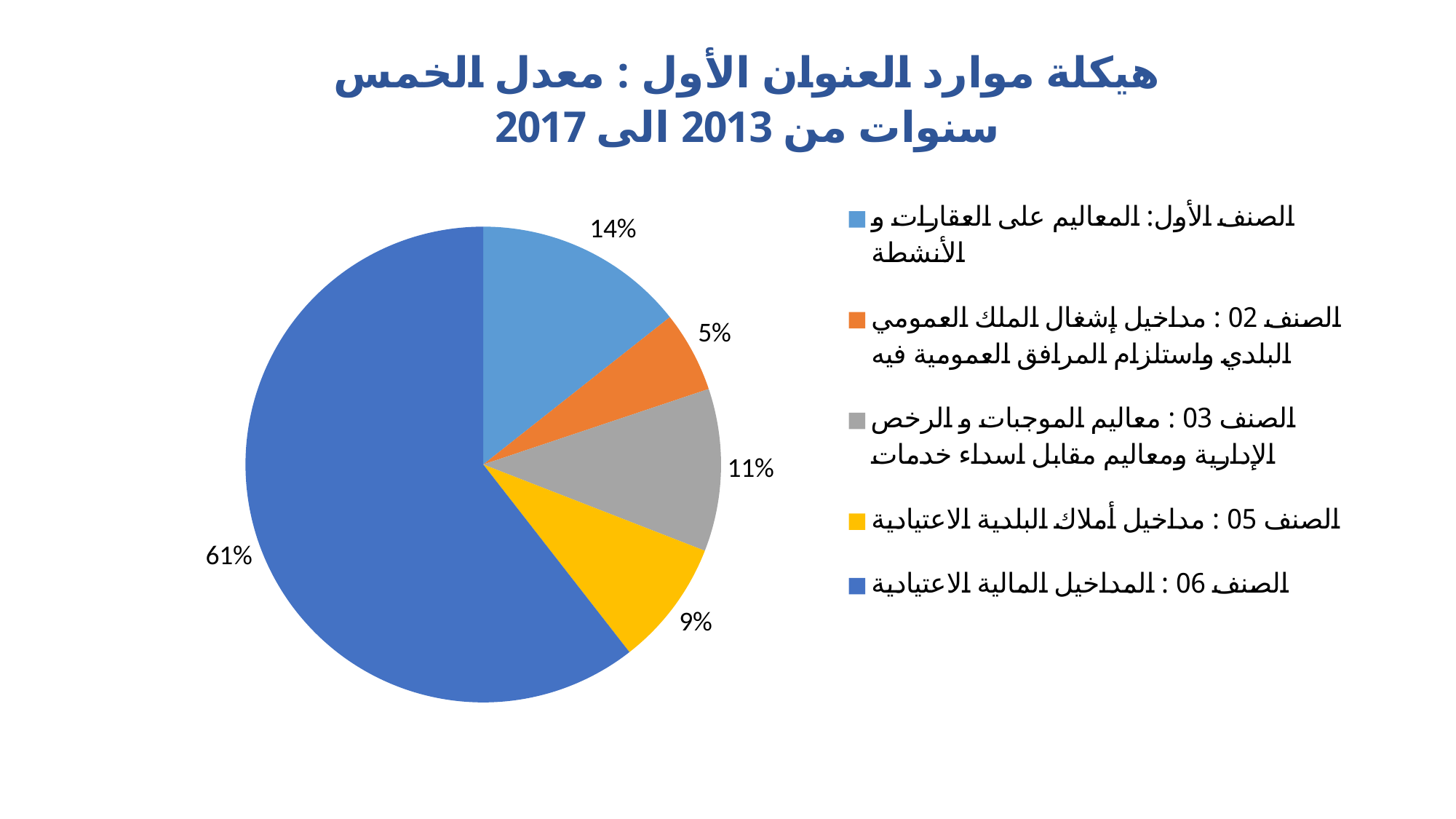
What is the value for الصنف 03 : معاليم الموجبات و الرخص الإدارية ومعاليم مقابل اسداء خدمات? 11% Which category has the smallest slice of the pie? الصنف 02 : مداخيل إشغال الملك العمومي البلدي واستلزام المرافق العمومية فيه Which is larger, the slice for الصنف 03 or the slice for الصنف 05? الصنف 03 What is the title of the chart? هيكلة موارد العنوان الأول : معدل الخمس سنوات من 2013 الى 2017 What percentage is shown for الصنف 02 : مداخيل إشغال الملك العمومي البلدي واستلزام المرافق العمومية فيه? 5% What kind of chart is shown on the slide? Pie chart How many slices does the pie chart have? 5 What is the difference in percentage points between الصنف 06 and الصنف الأول? 47 What percentage is shown for الصنف 05 : مداخيل أملاك البلدية الاعتيادية? 9% What is the value shown for الصنف الأول: المعاليم على العقارات و الأنشطة? 14% What share of the pie does الصنف 06 : المداخيل المالية الاعتيادية represent? 61% Which category has the largest slice of the pie? الصنف 06 : المداخيل المالية الاعتيادية